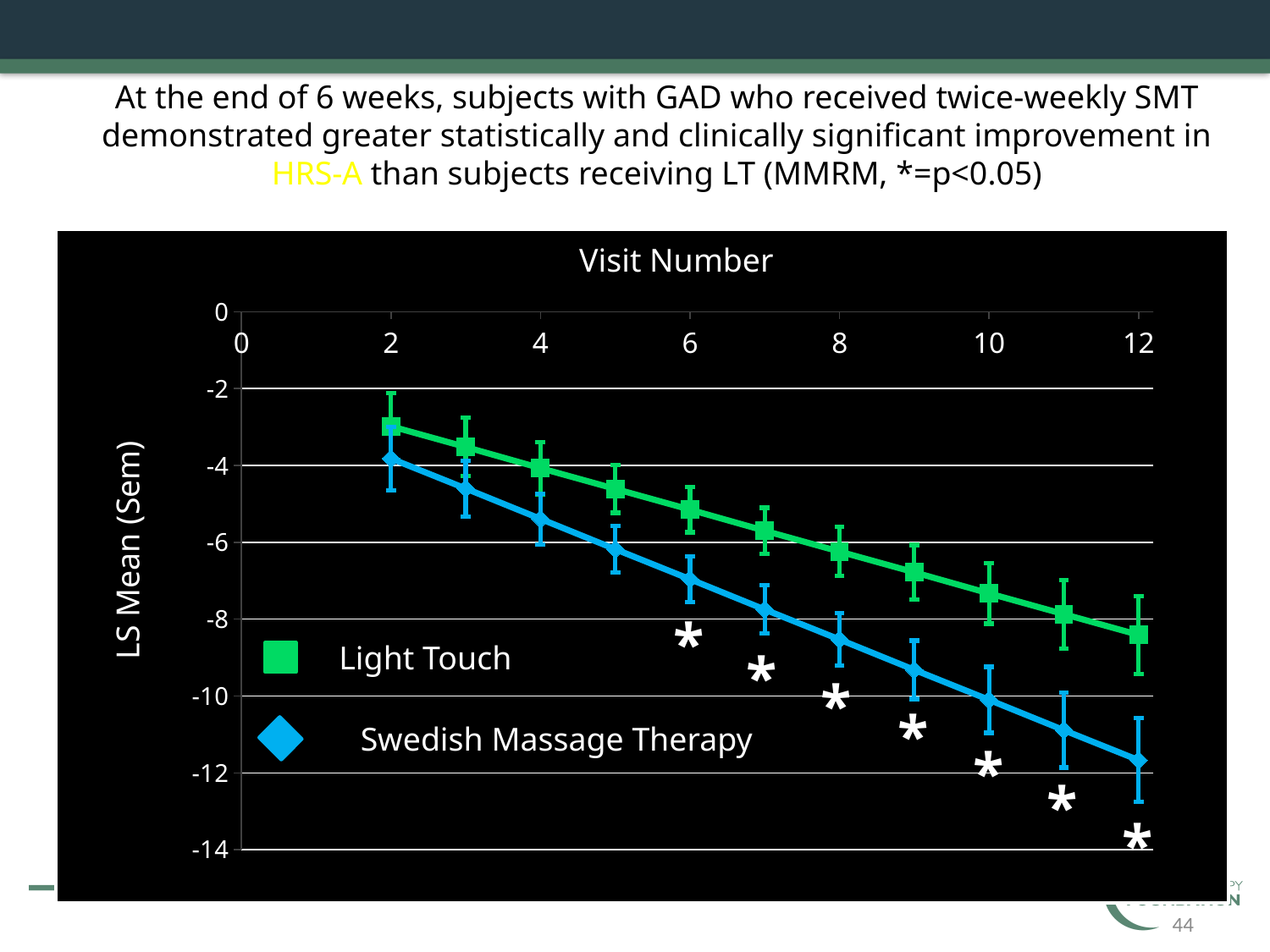
How many series does the legend list? 2 Is the Light Touch value at visit 2 greater or less than -4? greater What is the title of the vertical axis? LS Mean (Sem) Do the values for both series rise or fall as the visit number increases? fall Which two series are shown in the legend? Light Touch and Swedish Massage Therapy Is the Swedish Massage Therapy value at visit 12 greater or less than -10? less What kind of chart is shown on the slide? line chart Is the Light Touch value at visit 12 greater or less than -8? less How many data points are plotted for the Light Touch series? 11 At visit 8, which series has the higher (less negative) LS Mean value? Light Touch At visit 12, which series has the lower (more negative) LS Mean value? Swedish Massage Therapy